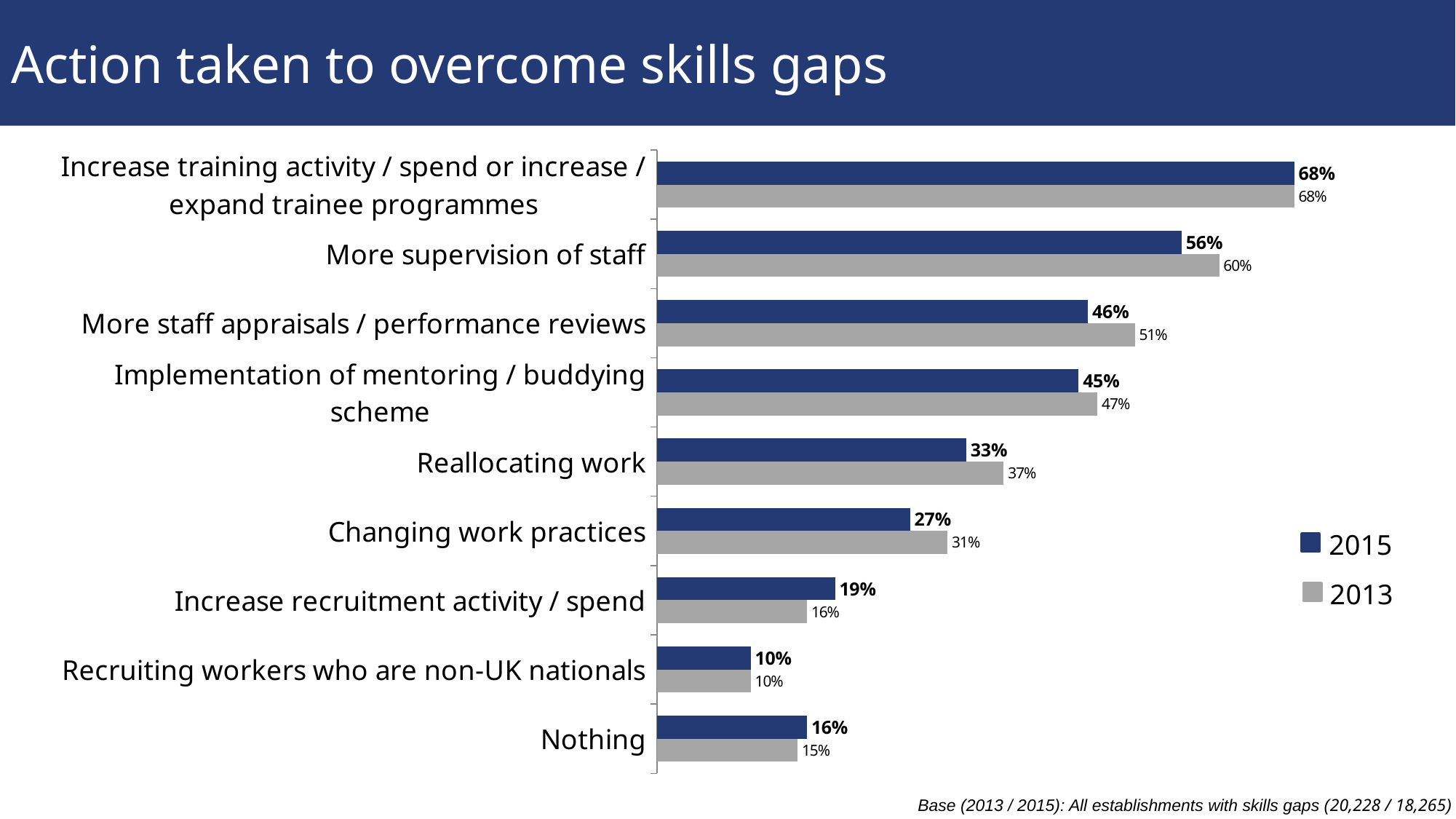
What is the 2015 value for 'Nothing'? 16% What kind of chart is shown on the slide? Bar chart For 'Changing work practices', which year has the larger value, 2015 or 2013? 2013 What is the difference between the 2013 and 2015 values for 'More staff appraisals / performance reviews'? 5% How many series does the legend list? 2 How many categories are shown on the chart? 9 Which category has the highest 2015 value? Increase training activity / spend or increase / expand trainee programmes What is the 2013 value for 'Reallocating work'? 37% Which colour represents the 2013 series in the legend? Grey Which category has the lowest 2013 value? Recruiting workers who are non-UK nationals For 'Increase recruitment activity / spend', which year has the larger value, 2015 or 2013? 2015 What is the 2015 value for 'More supervision of staff'? 56%